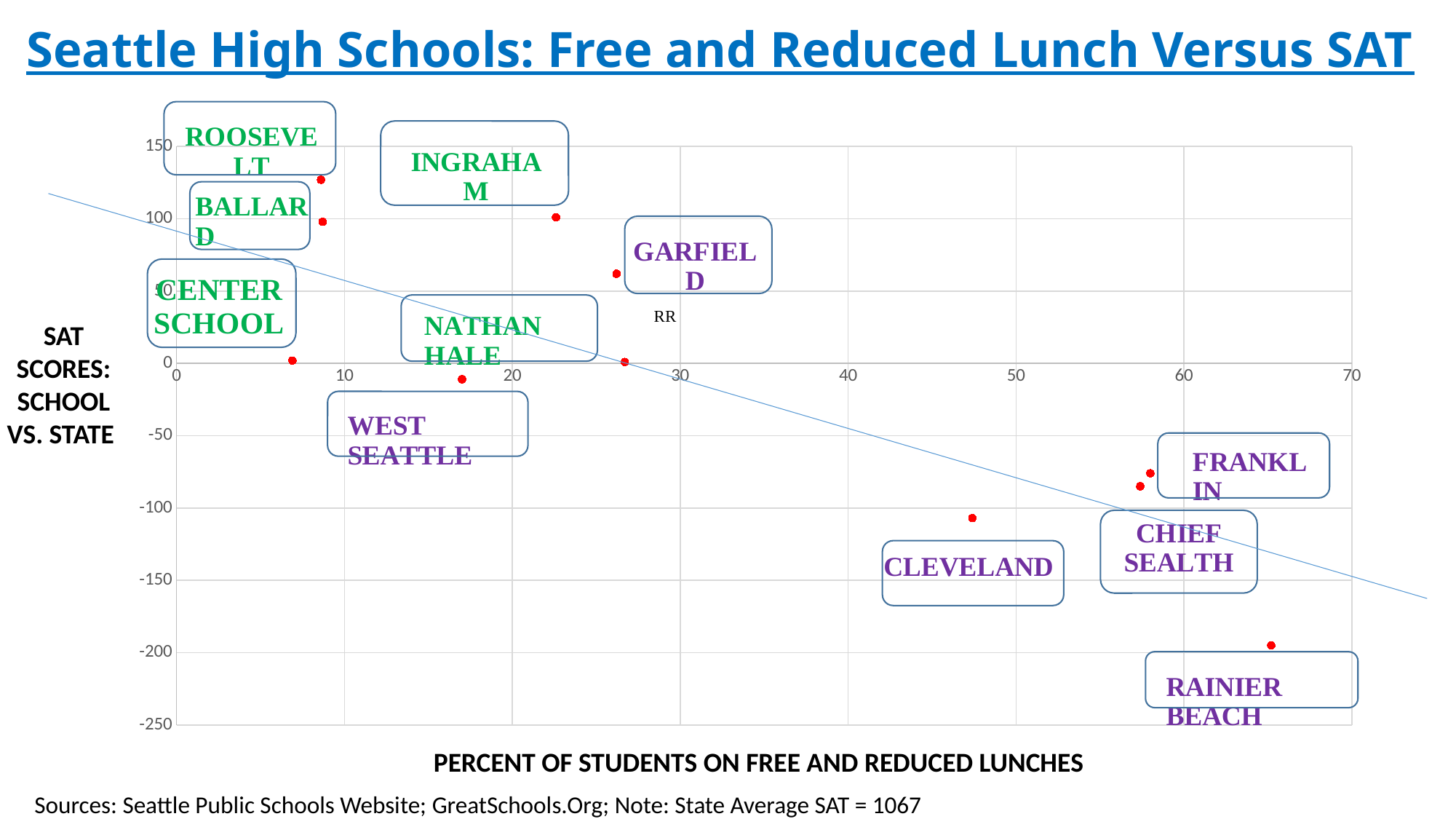
Which school has the highest SAT score value on the chart? Roosevelt Which school has a higher SAT score value, Ingraham or Garfield? Ingraham What is the title of the chart? Seattle High Schools: Free and Reduced Lunch Versus SAT Is the SAT score value for Chief Sealth greater or less than -50? less Is the SAT score value for Rainier Beach greater or less than -150? less What is the label of the horizontal axis? Percent of Students on Free and Reduced Lunches As the percent of students on free and reduced lunches increases, do the SAT score values generally rise or fall? Fall Is the SAT score value for Roosevelt greater or less than 100? greater How many schools are plotted as points on the chart? 11 What kind of chart is shown on the slide? Scatter chart Which school has the highest percent of students on free and reduced lunches? Rainier Beach Which school has the lowest SAT score value on the chart? Rainier Beach